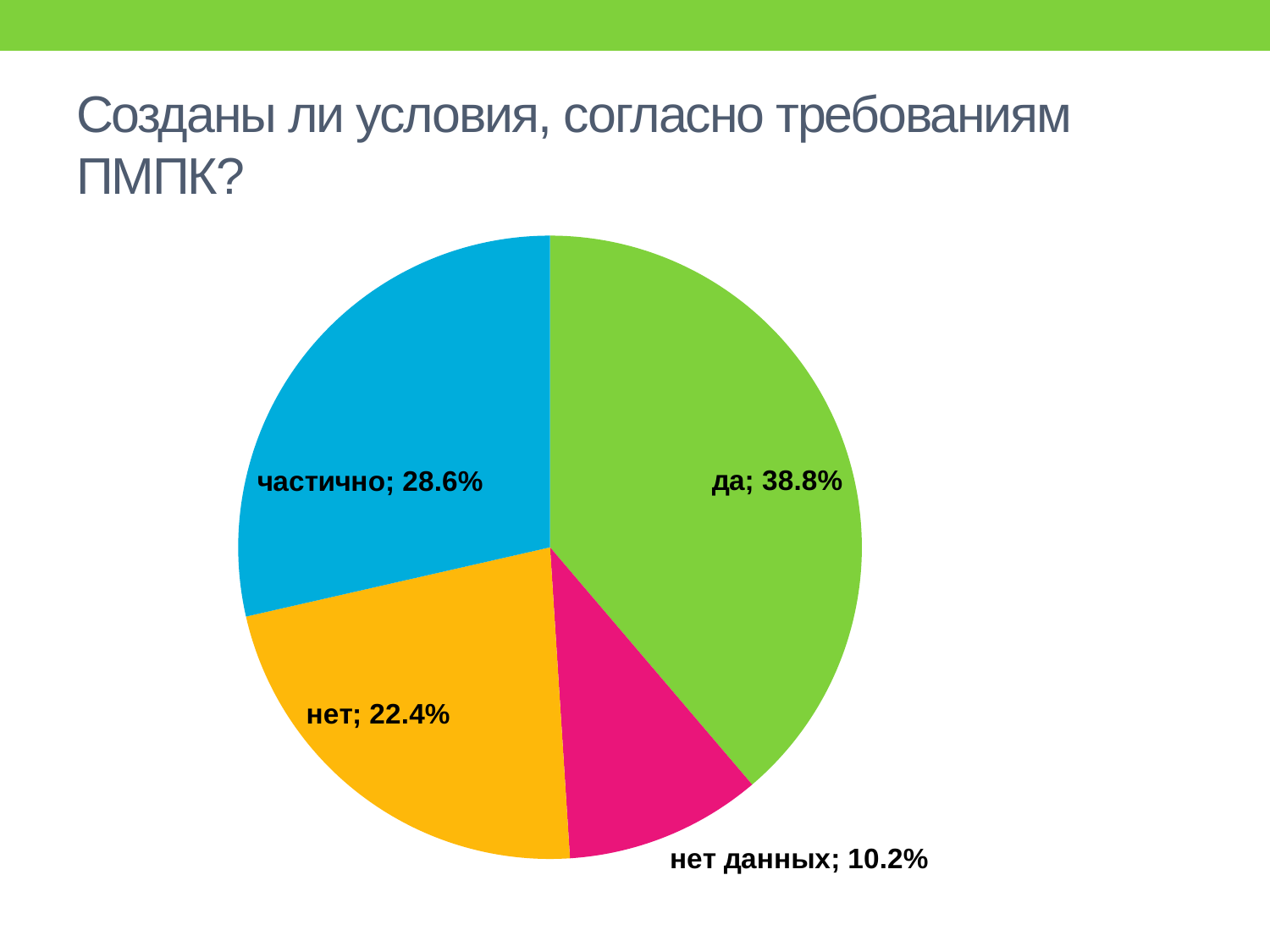
What colour is the "нет данных" slice? pink (magenta) What share of the pie does the "да" slice represent? 38.8% What is the difference in percentage points between "да" and "нет"? 16.4 Which category has the largest slice of the pie? да What is the combined share of "да" and "частично"? 67.4% What is the value shown for "нет"? 22.4% How many slices does the pie chart have? 4 What kind of chart is shown on the slide? pie chart Which category has the smallest slice of the pie? нет данных What is the value shown for "частично"? 28.6% What is the value shown for "нет данных"? 10.2% Which is larger, the share for "частично" or the share for "нет"? частично